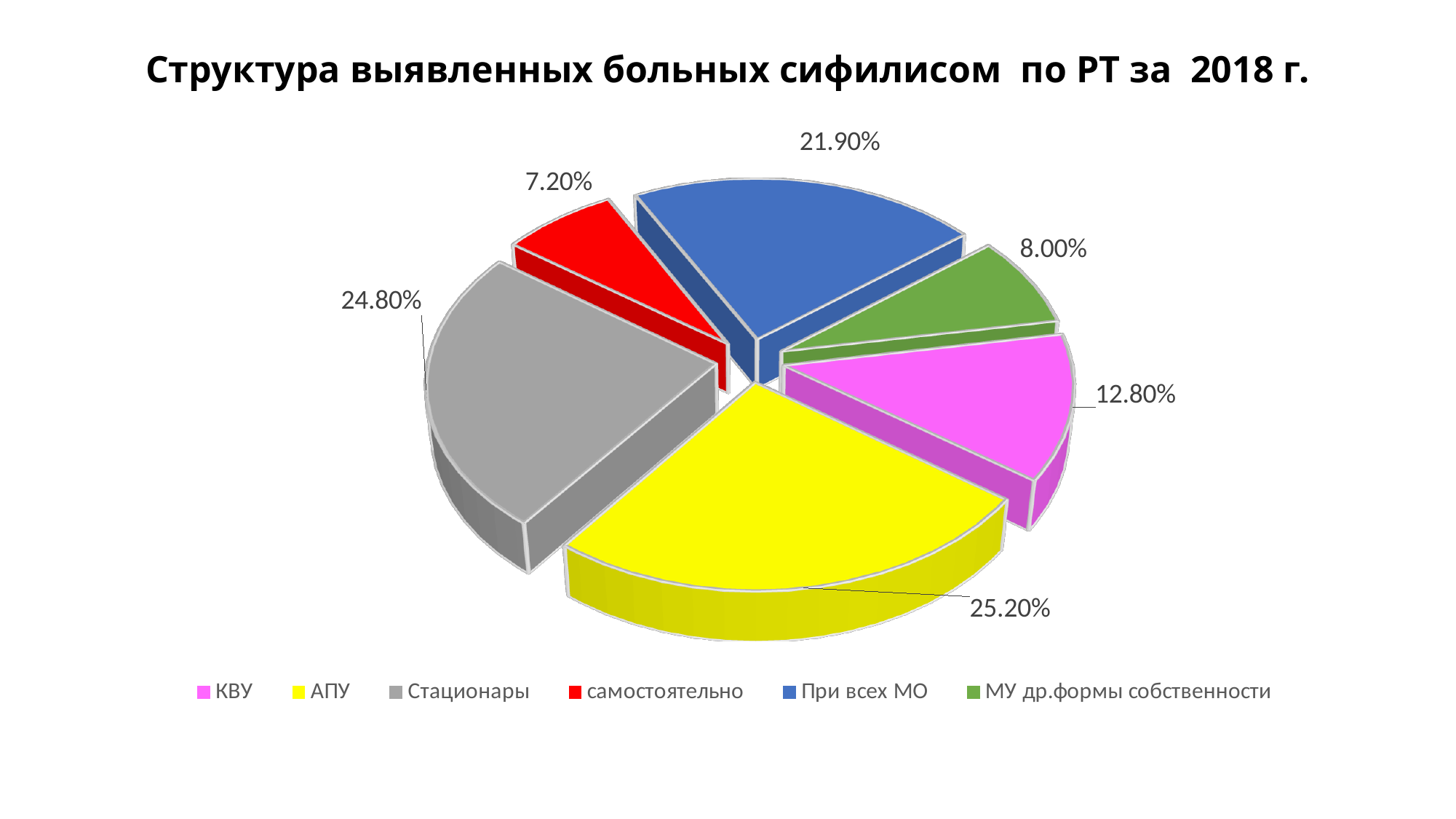
What is the value for МУ др.формы собственности? 8.00% How many categories does the pie chart show? 6 What is the value shown for Стационары? 24.80% What share is shown for самостоятельно? 7.20% What percentage is labelled for При всех МО? 21.90% Which category has the largest slice of the pie? АПУ What type of chart is shown on the slide? Pie chart What share of the pie does АПУ account for? 25.20% Which category has the smallest slice of the pie? самостоятельно Which is larger, the share for При всех МО or the share for КВУ? При всех МО What is the difference between the shares of АПУ and КВУ? 12.40% What is the value for КВУ? 12.80%